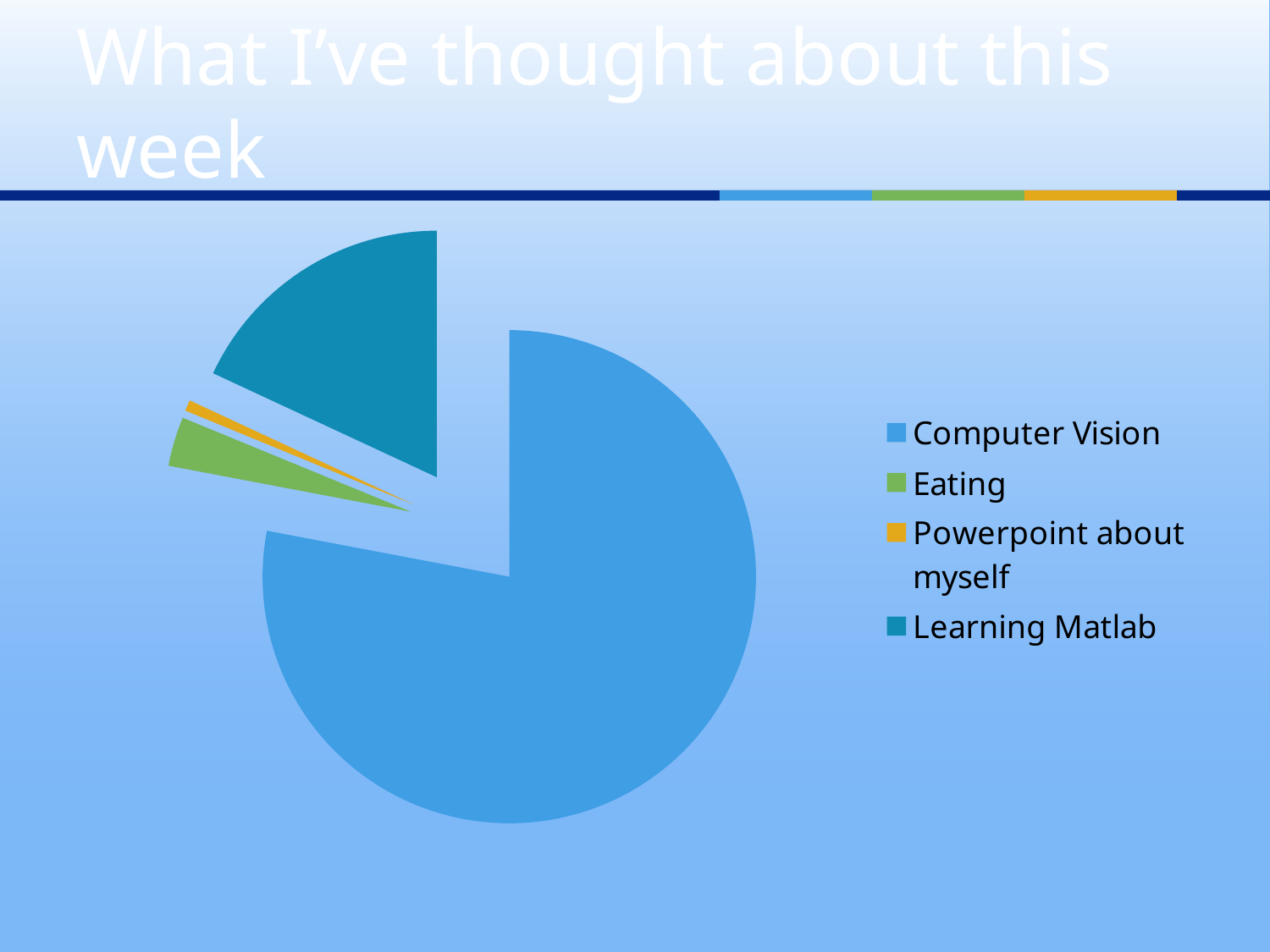
What is the title of the slide containing the pie chart? What I've thought about this week Which slice is larger, Eating or Powerpoint about myself? Eating Which category has the largest slice of the pie chart? Computer Vision Which category is shown in green in the pie chart? Eating Which category has the smallest slice of the pie chart? Powerpoint about myself What kind of chart is shown on the slide? pie chart Which category has the second-largest slice of the pie chart? Learning Matlab Which slice is larger, Learning Matlab or Eating? Learning Matlab How many categories does the pie chart have? 4